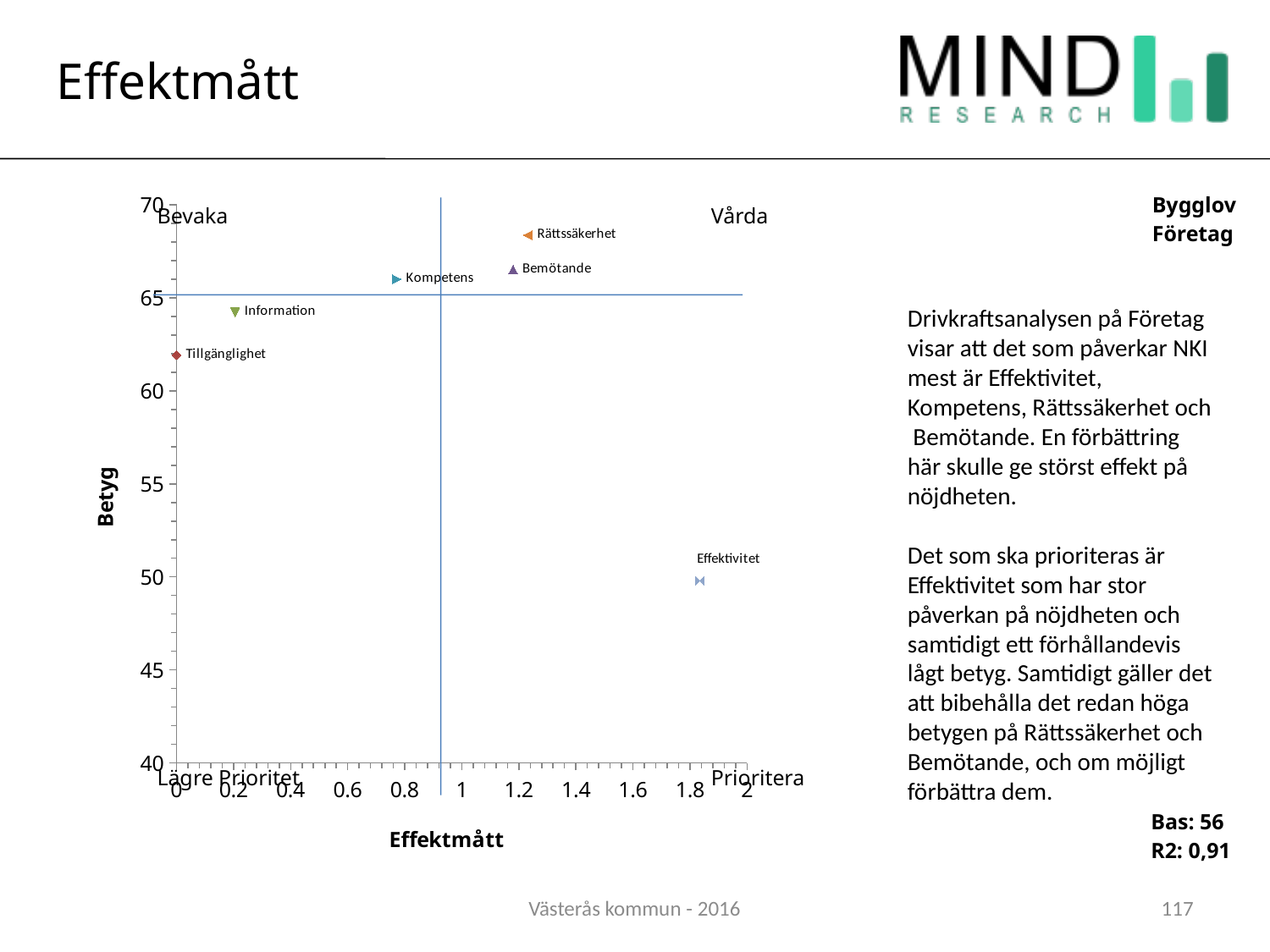
What label appears in the upper-right quadrant of the chart? Vårda Is the Betyg value for Rättssäkerhet greater or less than 65? greater Which point has the lowest Betyg value? Effektivitet Which has a higher Betyg value, Rättssäkerhet or Information? Rättssäkerhet What kind of chart is shown on the slide? Scatter chart Which point has the lowest Effektmått value? Tillgänglighet Which point has the highest Betyg value? Rättssäkerhet Is the Betyg value for Effektivitet greater or less than 55? less Which point has the highest Effektmått value? Effektivitet How many labelled data points are plotted in the chart? 6 Is the Effektmått value for Kompetens greater or less than 1? less What is the title of the horizontal axis of the chart? Effektmått